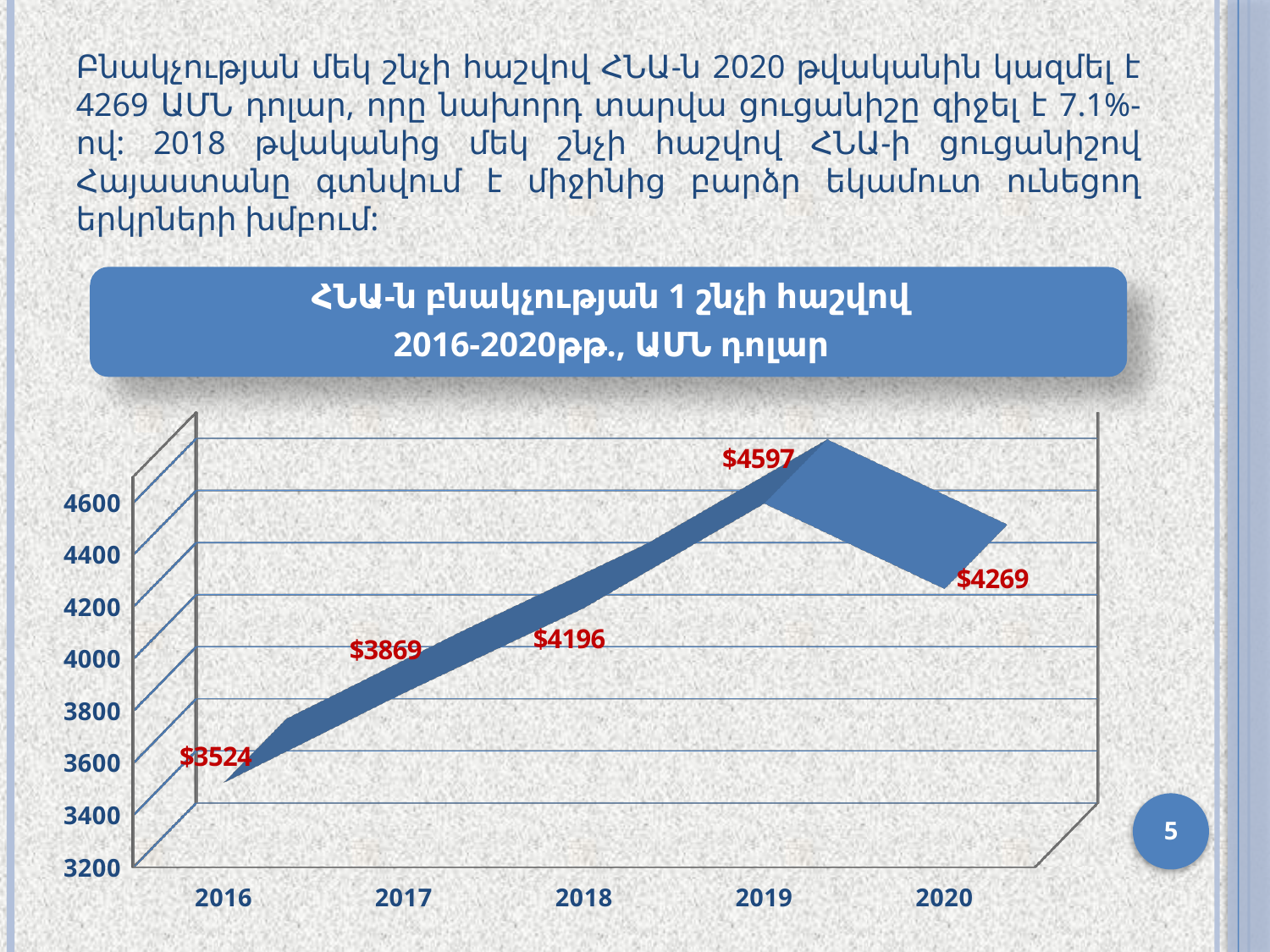
What is the value shown for 2016? $3524 Is the value for 2017 greater or less than 4000? less Which year has the highest value on the chart? 2019 What is the difference between the 2017 value and the 2016 value? $345 What kind of chart is shown on the slide? line chart How many years are plotted on the chart? 5 Which year has the lowest value on the chart? 2016 Which is larger, the value for 2018 or the value for 2020? 2020 What is the GDP per capita value shown for 2019? $4597 Do the values rise or fall from 2016 to 2019? rise What is the value shown for 2018? $4196 What is the difference between the 2019 value and the 2020 value? $328